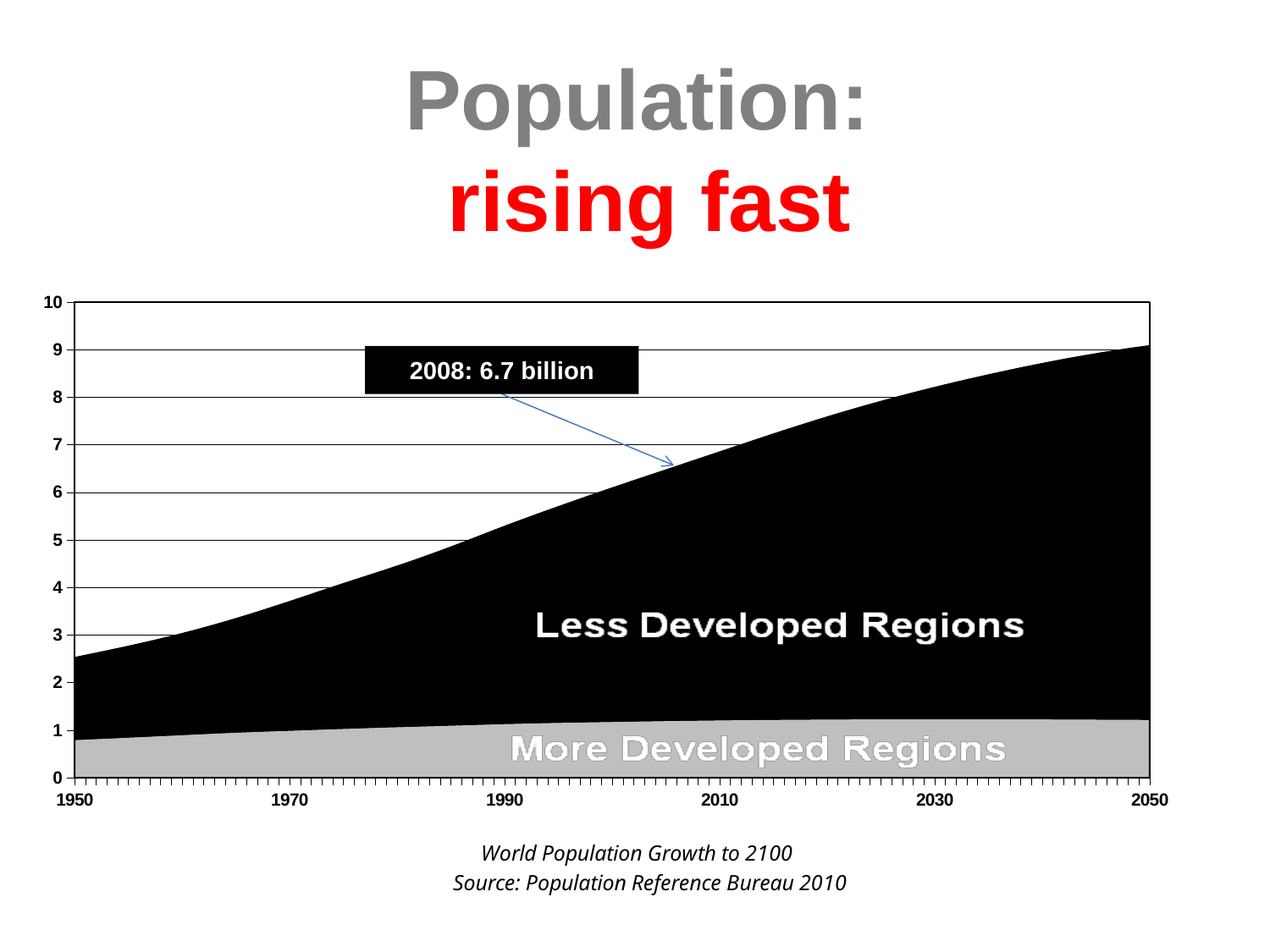
In 2010, which region has the larger population, Less Developed Regions or More Developed Regions? Less Developed Regions Is the total population in 1950 greater or less than 3? less What world population value does the annotation give for 2008? 6.7 billion How many year labels are shown on the x axis? 6 Is the total population in 2030 greater or less than 7? greater Is the population of More Developed Regions in 2050 greater or less than 2? less What is the source cited below the chart? Population Reference Bureau 2010 In which year shown on the x axis is the total population highest? 2050 What kind of chart is shown on the slide? Area chart How many regional series are plotted in the chart? 2 Does the total world population rise or fall from 1950 to 2050 in the chart? Rises